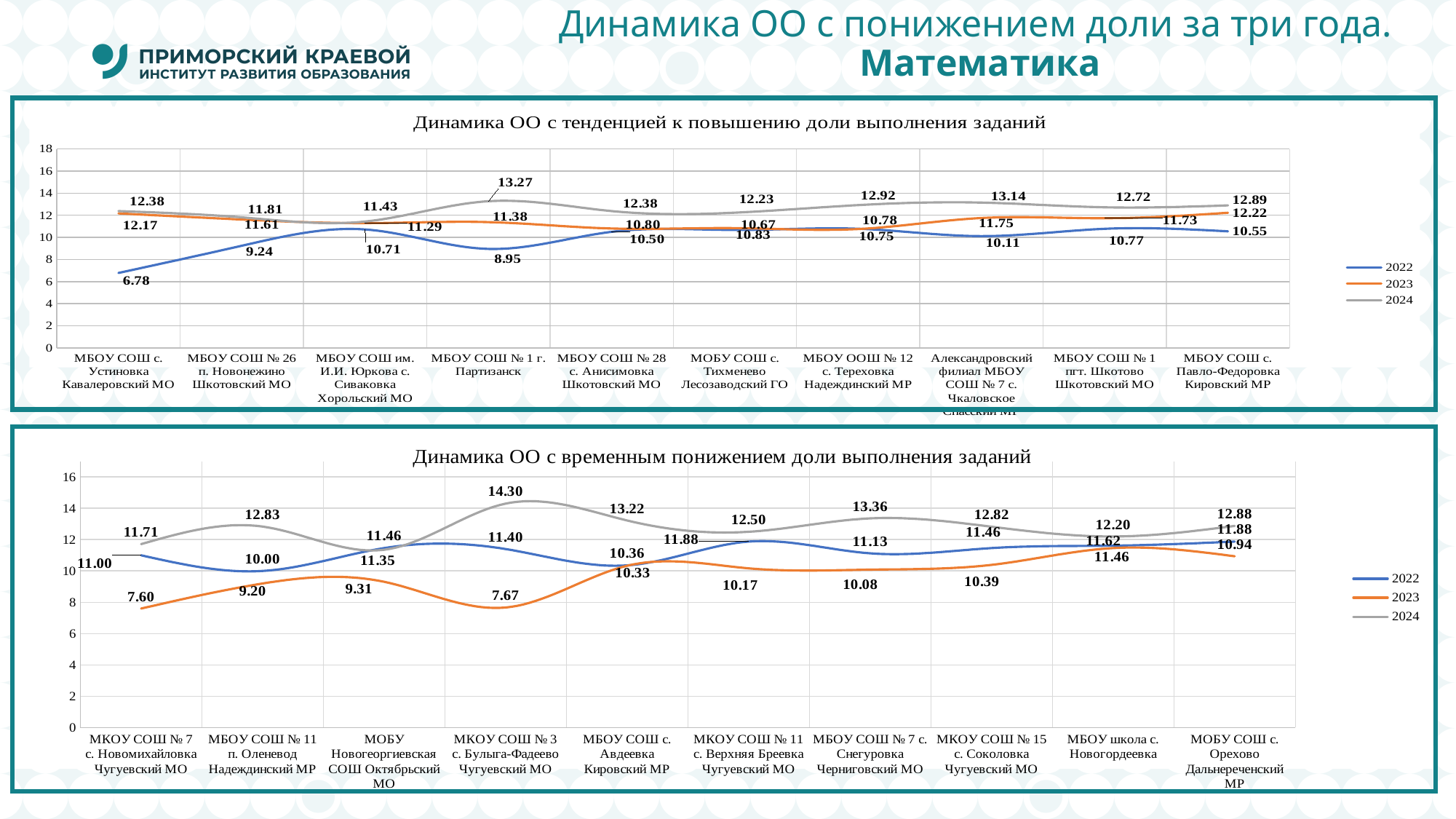
What type of chart is the bottom chart? Line chart How many schools are shown on the x axis of the bottom chart? 10 In the bottom chart 'Динамика ОО с временным понижением доли выполнения заданий', what is the 2023 value for МКОУ СОШ № 3 с. Булыга-Фадеево Чугуевский МО? 7.67 In the top chart, which school has the highest 2024 value? МБОУ СОШ № 1 г. Партизанск In the top chart 'Динамика ОО с тенденцией к повышению доли выполнения заданий', what is the 2022 value for МБОУ СОШ с. Устиновка Кавалеровский МО? 6.78 In the bottom chart, which is larger for МБОУ СОШ № 11 п. Оленевод Надеждинский МР: the 2022 value or the 2024 value? 2024 In the bottom chart, which school has the highest 2024 value? МКОУ СОШ № 3 с. Булыга-Фадеево Чугуевский МО In the top chart, which school has the lowest 2022 value? МБОУ СОШ с. Устиновка Кавалеровский МО In the top chart, what is the difference between the 2023 and 2022 values for МБОУ СОШ № 26 п. Новонежино Шкотовский МО? 2.37 How many series does the legend of the top chart list? 3 In the top chart, what is the 2024 value for МБОУ СОШ № 1 г. Партизанск? 13.27 In the bottom chart, which school has the lowest 2023 value? МКОУ СОШ № 7 с. Новомихайловка Чугуевский МО